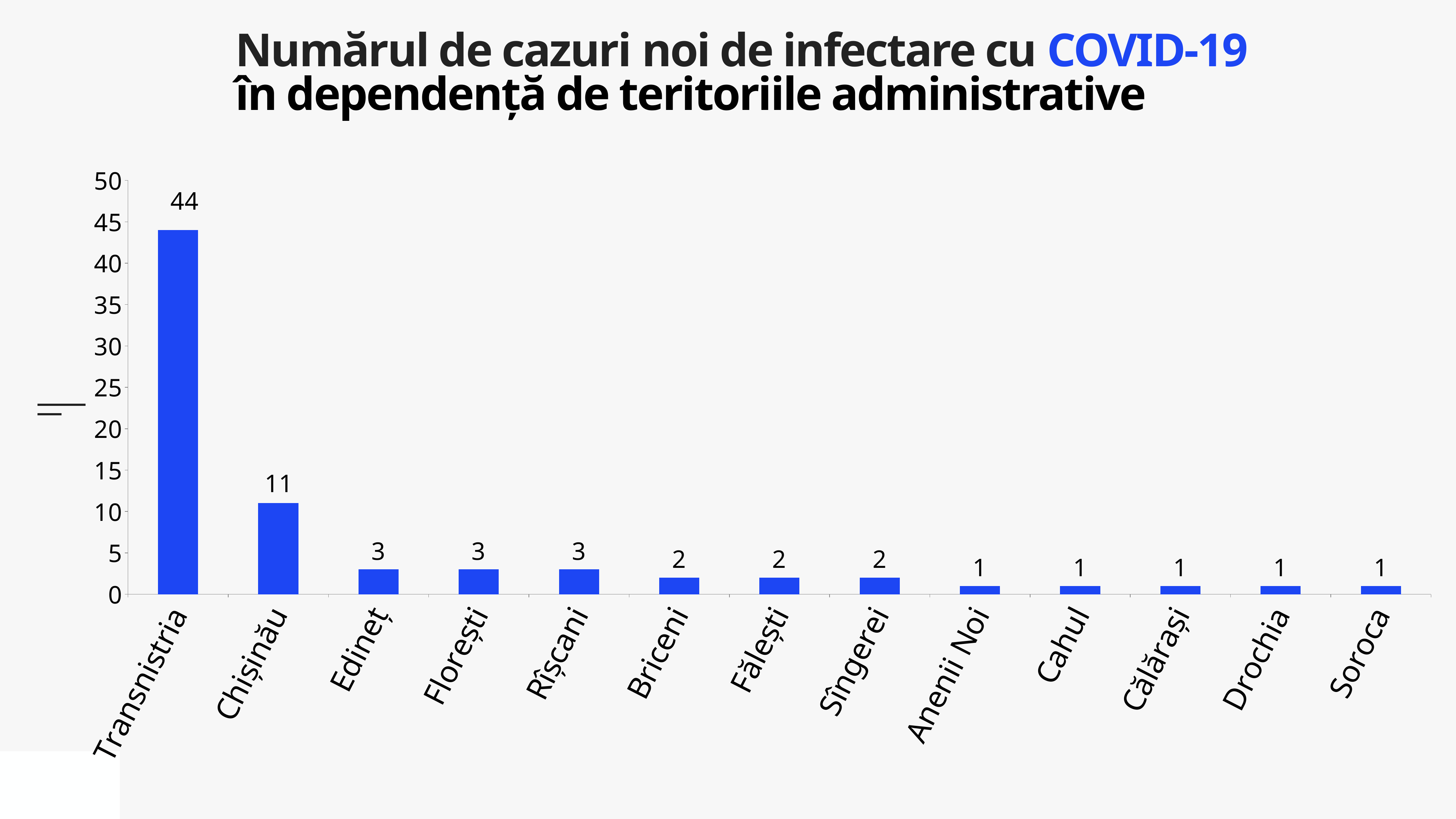
What is the difference between the values for Edineț and Briceni? 1 What kind of chart is shown on the slide? bar chart Do the values rise or fall from left to right along the x axis? fall What is the difference between the values for Transnistria and Chișinău? 33 Which is larger, the value for Chișinău or the value for Rîșcani? Chișinău What is the value for Transnistria? 44 What is the value for Chișinău? 11 What is the value for Sîngerei? 2 Is the value for Transnistria greater or less than 40? greater How many categories are shown on the x axis? 13 Which category has the highest value? Transnistria What is the value for Drochia? 1